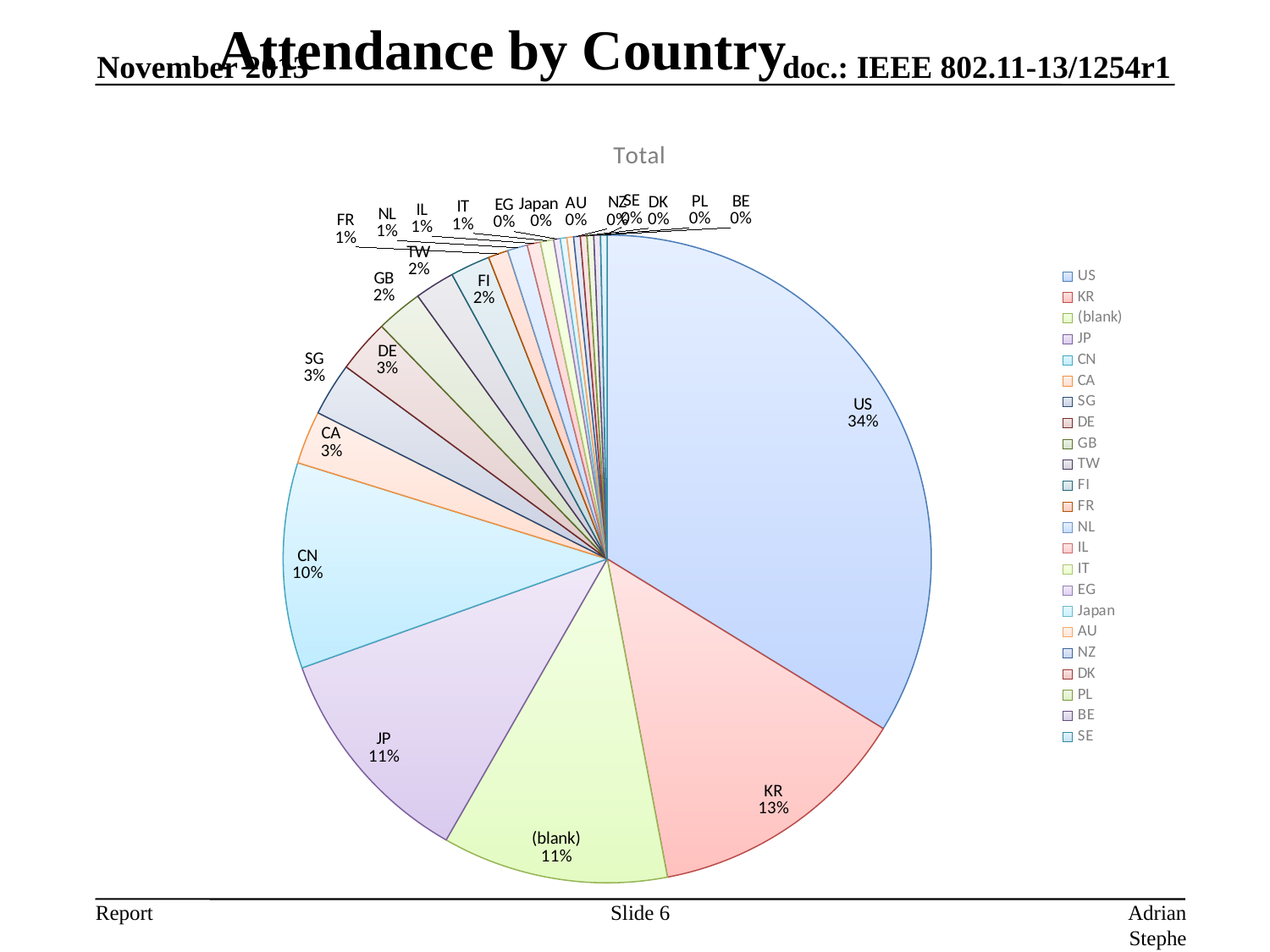
What is the chart's title? Total What percentage is shown for the (blank) slice? 11% Which has a larger share, JP or CN? JP What kind of chart is shown on the slide? pie chart What percentage of attendance is from CN? 10% What percentage of attendance is from US? 34% What is the difference in percentage points between US and KR? 21 What is the difference in percentage points between KR and JP? 2 What percentage of attendance is from KR? 13% What percentage of attendance is from DE? 3% How many entries does the legend list? 23 Which country has the largest share of attendance? US